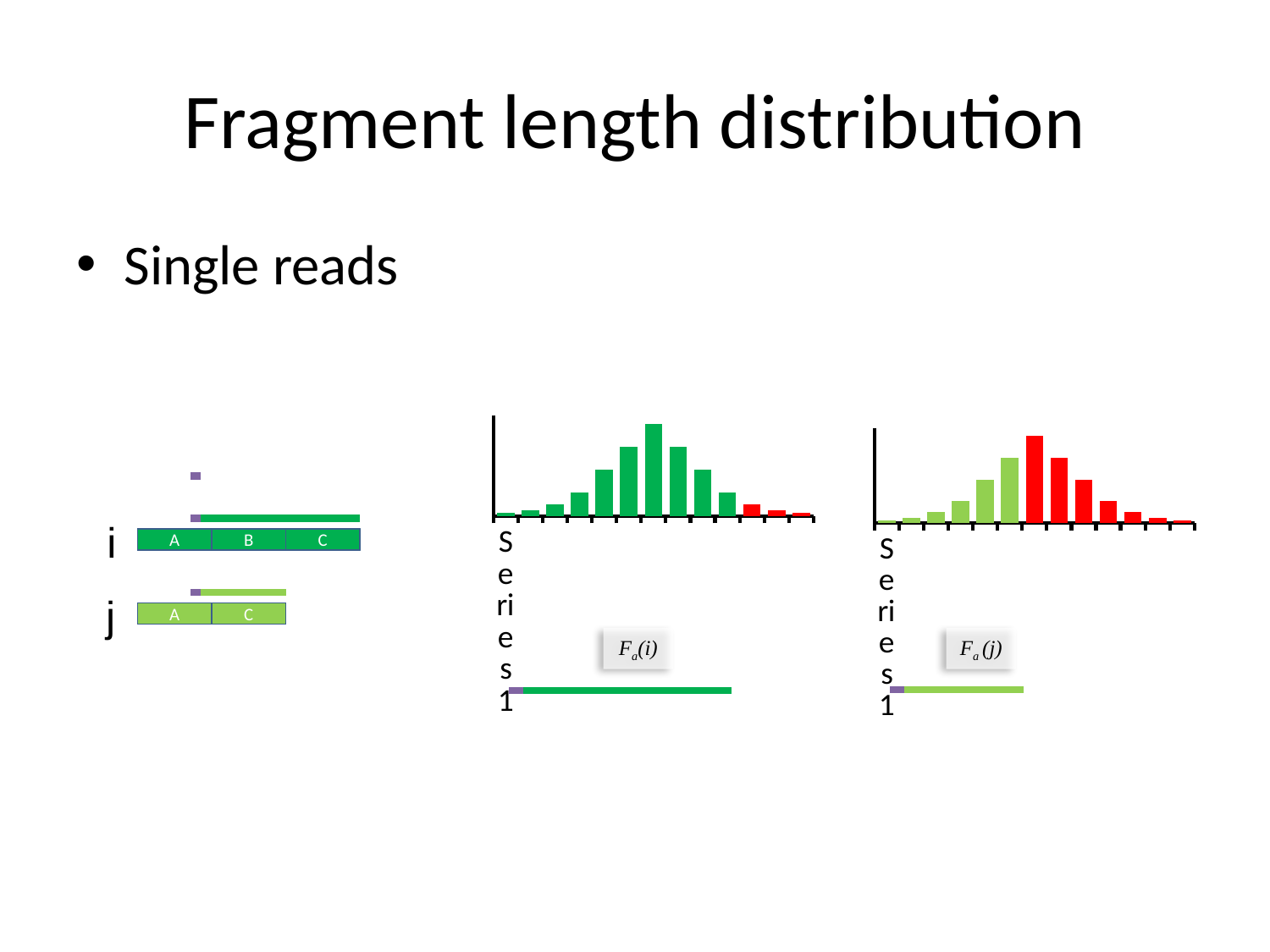
What is the legend entry shown under the left chart? Series 1 In the left chart, do the bar heights rise or fall moving from the middle toward the right end of the x axis? fall What kind of chart is the right chart (labelled F_a(j))? bar chart How many series does the legend of the left chart list? 1 In the left chart, is the tallest bar green or red? green In the left chart, do the bar heights rise or fall moving from the left edge toward the middle of the x axis? rise In the right chart, is the tallest bar green or red? red How many series does the legend of the right chart list? 1 In the left chart, what colour are the bars on the far right of the x axis? red In the right chart, do the bar heights rise or fall moving from the tallest bar toward the right end of the x axis? fall What kind of chart is the left chart (labelled F_a(i))? bar chart